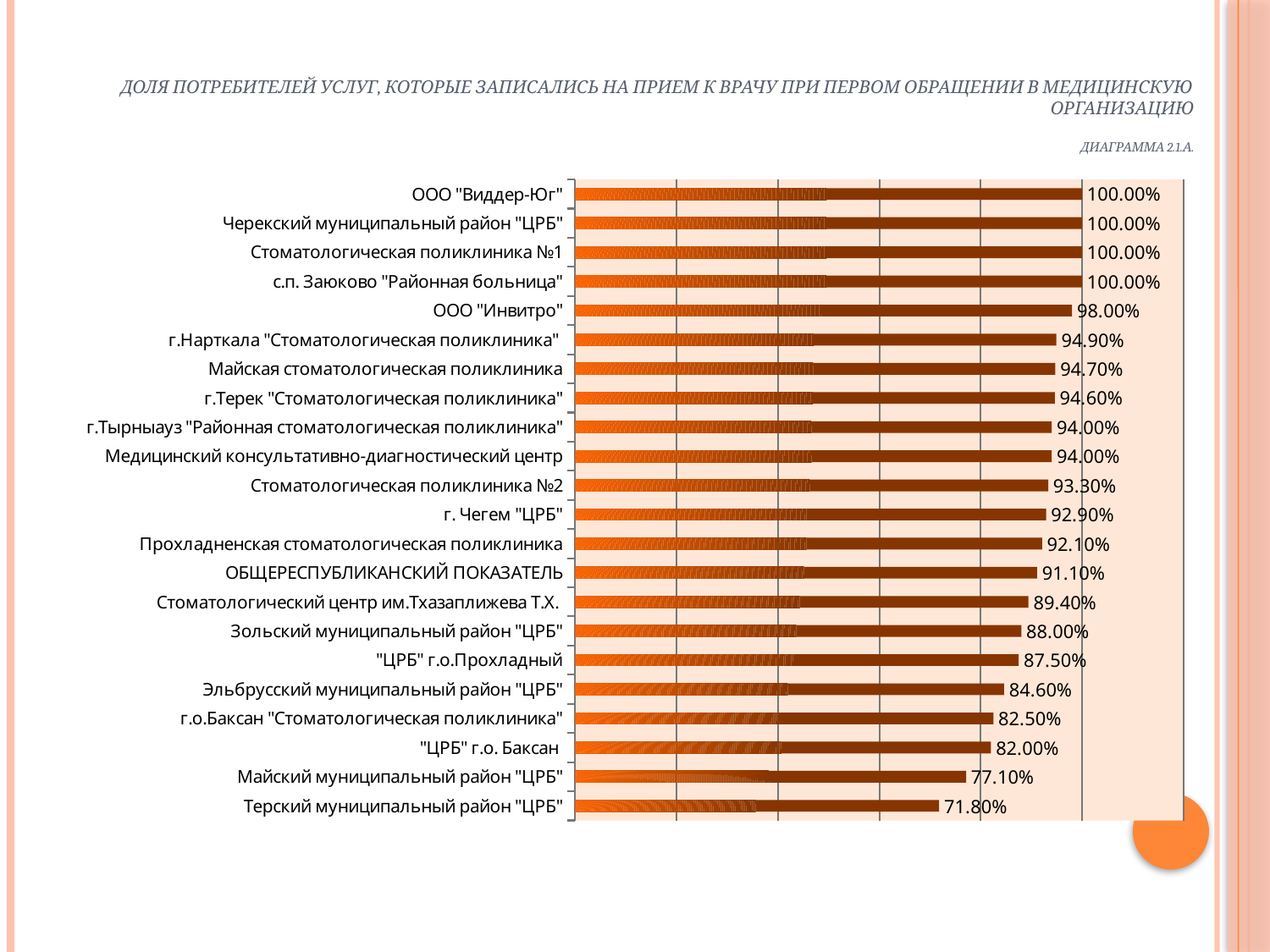
What is the value for Терский муниципальный район "ЦРБ"? 71.80% Which category has the lowest value? Терский муниципальный район "ЦРБ" Which is larger: the value for Майский муниципальный район "ЦРБ" or the value for "ЦРБ" г.о. Баксан? "ЦРБ" г.о. Баксан What is the diagram number given under the chart title? ДИАГРАММА 2.1.А. What is the value for ООО "Инвитро"? 98.00% What is the difference between the value for ООО "Инвитро" and the value for г.Нарткала "Стоматологическая поликлиника"? 3.10% What kind of chart is shown on the slide? Bar chart What is the difference between the value for ОБЩЕРЕСПУБЛИКАНСКИЙ ПОКАЗАТЕЛЬ and the value for Терский муниципальный район "ЦРБ"? 19.30% How many categories have a value of 100.00%? 4 What is the value for Эльбрусский муниципальный район "ЦРБ"? 84.60% How many categories are shown in the chart? 22 What is the value for ОБЩЕРЕСПУБЛИКАНСКИЙ ПОКАЗАТЕЛЬ? 91.10%